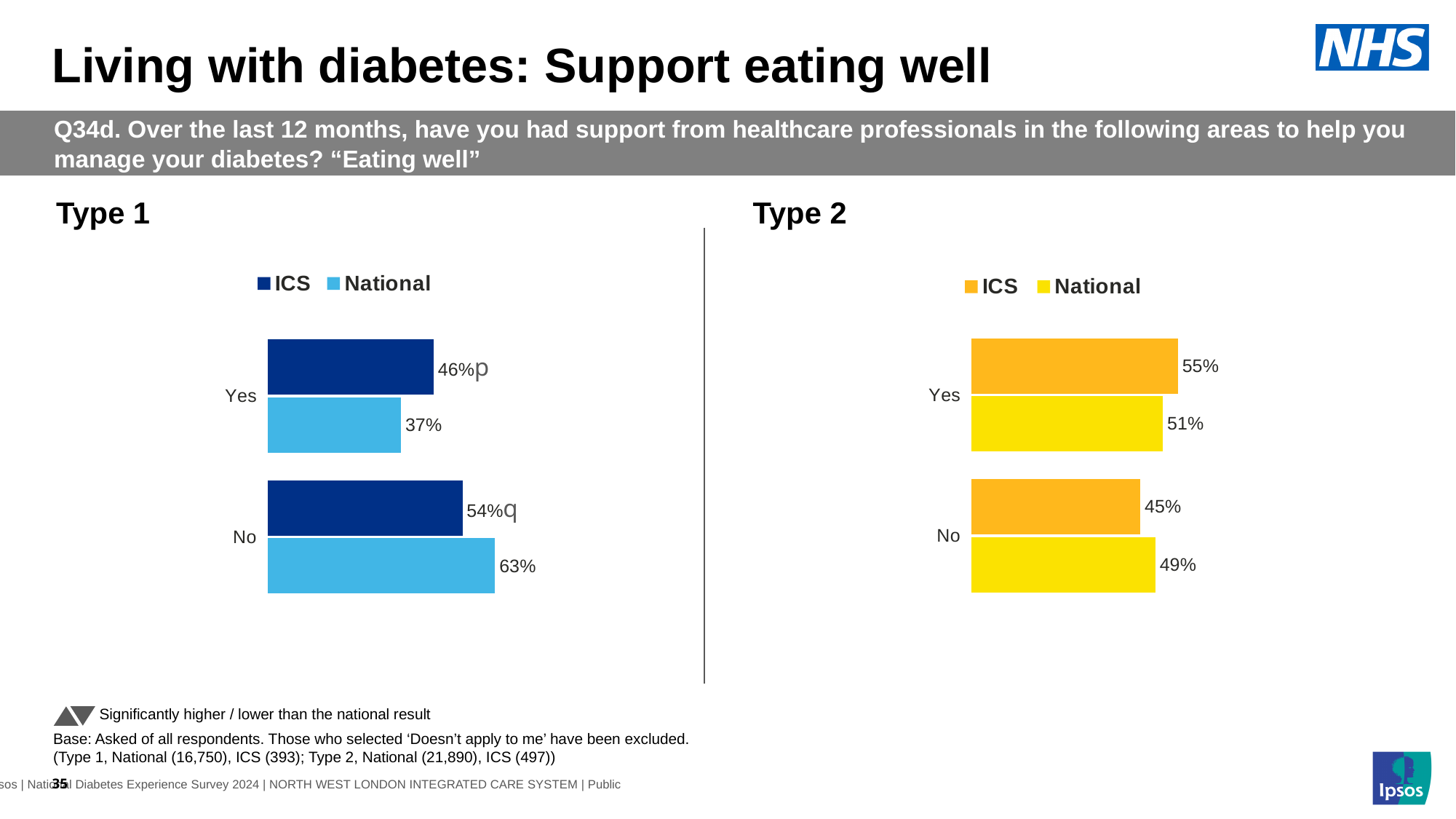
In the Type 2 chart, which category has the lowest ICS value? No How many series does the legend of the Type 2 chart list? 2 In the Type 2 chart, which is larger for No, the ICS value or the National value? National In the Type 1 chart, which category has the highest National value? No In the Type 1 chart, what is the National value for No? 63% In the Type 2 chart, what is the difference between the ICS and National values for Yes? 4% In the Type 1 chart, what is the ICS value for Yes? 46% In the Type 2 chart, what is the ICS value for Yes? 55% In the Type 1 chart, what is the difference between the ICS and National values for No? 9% In the Type 1 chart, which is larger for Yes, the ICS value or the National value? ICS What kind of chart is the Type 1 chart? Bar chart In the Type 2 chart, what is the National value for No? 49%